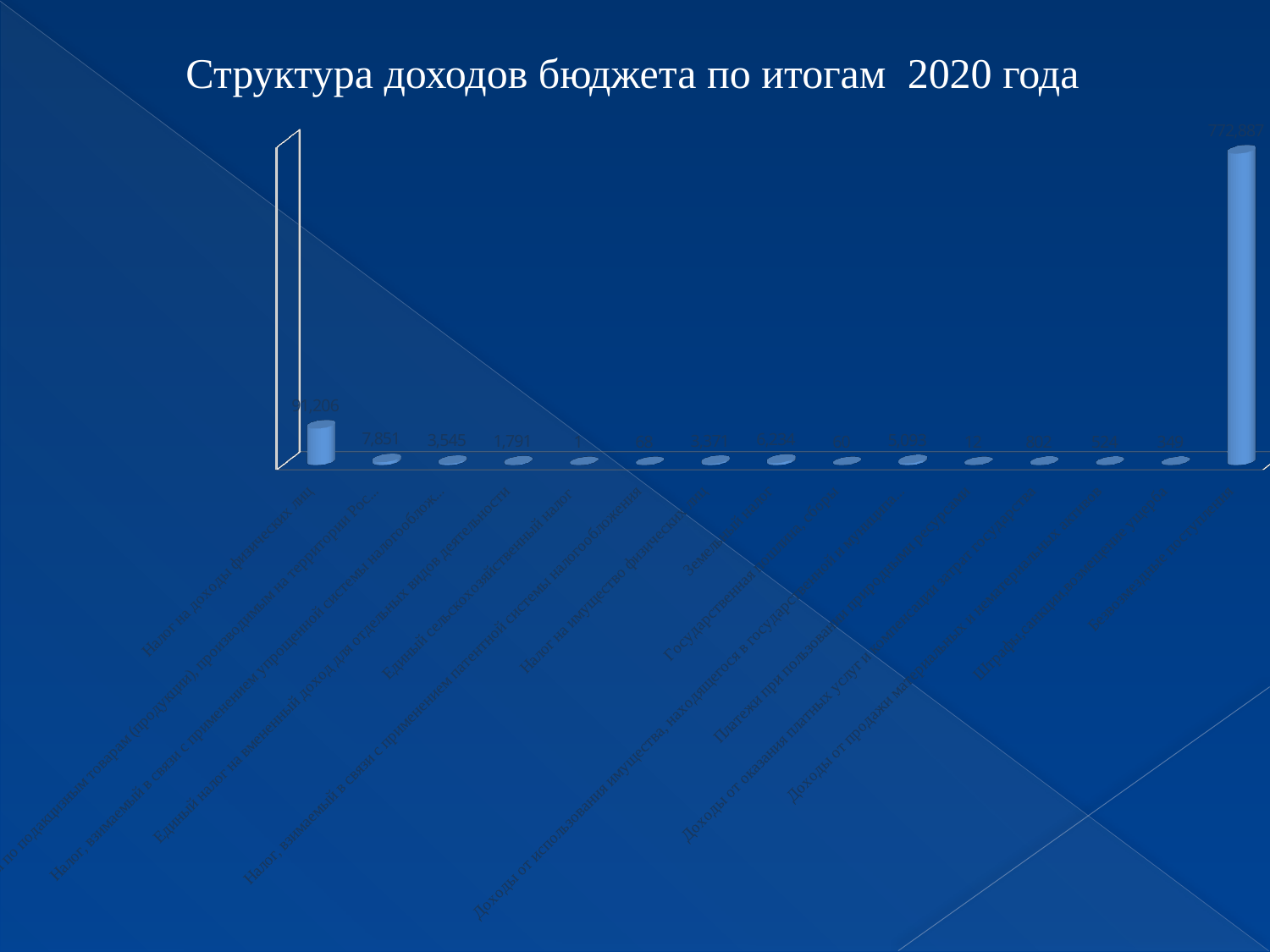
What is the title of the chart on the slide? Структура доходов бюджета по итогам 2020 года What is the difference between the values labelled on the second and third bars from the left (7,851 and 3,545)? 4,306 Which is larger: the value on the second bar from the left or the value on the fourth bar from the left? the second bar from the left What value is labelled on the second bar from the left? 7,851 What kind of chart is shown on the slide? bar chart How many bars are plotted in the chart? 15 What value is labelled on the third bar from the left? 3,545 What colour are the bars in the chart? light blue Which bar in the chart is the tallest? the rightmost bar Which is taller: the leftmost bar or the rightmost bar? the rightmost bar What value is labelled on the fourth bar from the left? 1,791